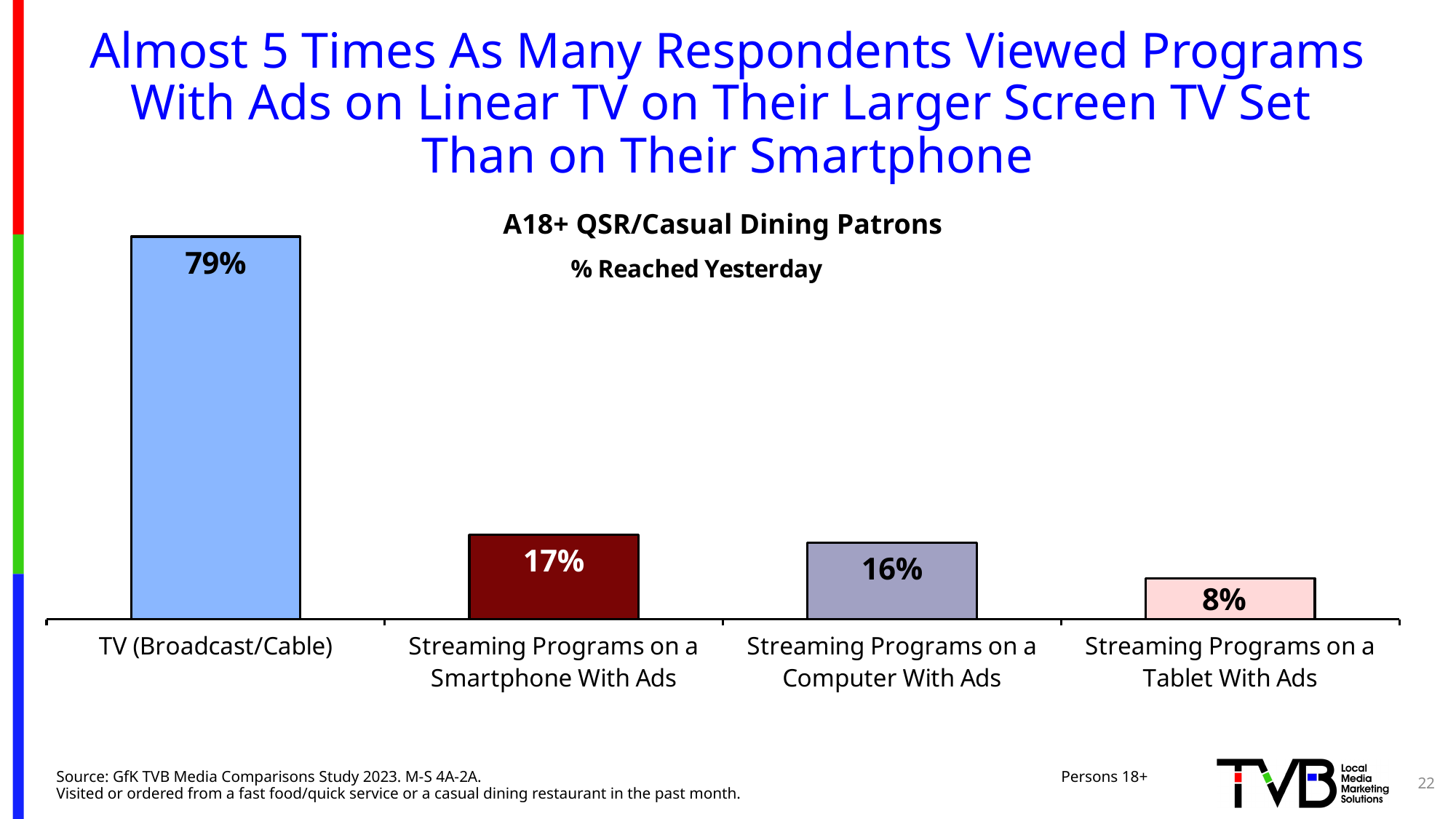
What is the title of the chart? A18+ QSR/Casual Dining Patrons % Reached Yesterday What is the difference in % reached yesterday between Streaming Programs on a Computer With Ads and Streaming Programs on a Tablet With Ads? 8 percentage points What is the % reached yesterday for Streaming Programs on a Computer With Ads? 16% How many categories are shown in the chart? 4 Which is larger: the % reached yesterday for Streaming Programs on a Smartphone With Ads or for Streaming Programs on a Tablet With Ads? Streaming Programs on a Smartphone With Ads What is the difference in % reached yesterday between TV (Broadcast/Cable) and Streaming Programs on a Smartphone With Ads? 62 percentage points What is the % reached yesterday for Streaming Programs on a Smartphone With Ads? 17% What kind of chart is shown on the slide? Bar chart What is the % reached yesterday for Streaming Programs on a Tablet With Ads? 8% Which category has the highest % reached yesterday? TV (Broadcast/Cable) Which category has the lowest % reached yesterday? Streaming Programs on a Tablet With Ads What is the % reached yesterday for TV (Broadcast/Cable)? 79%